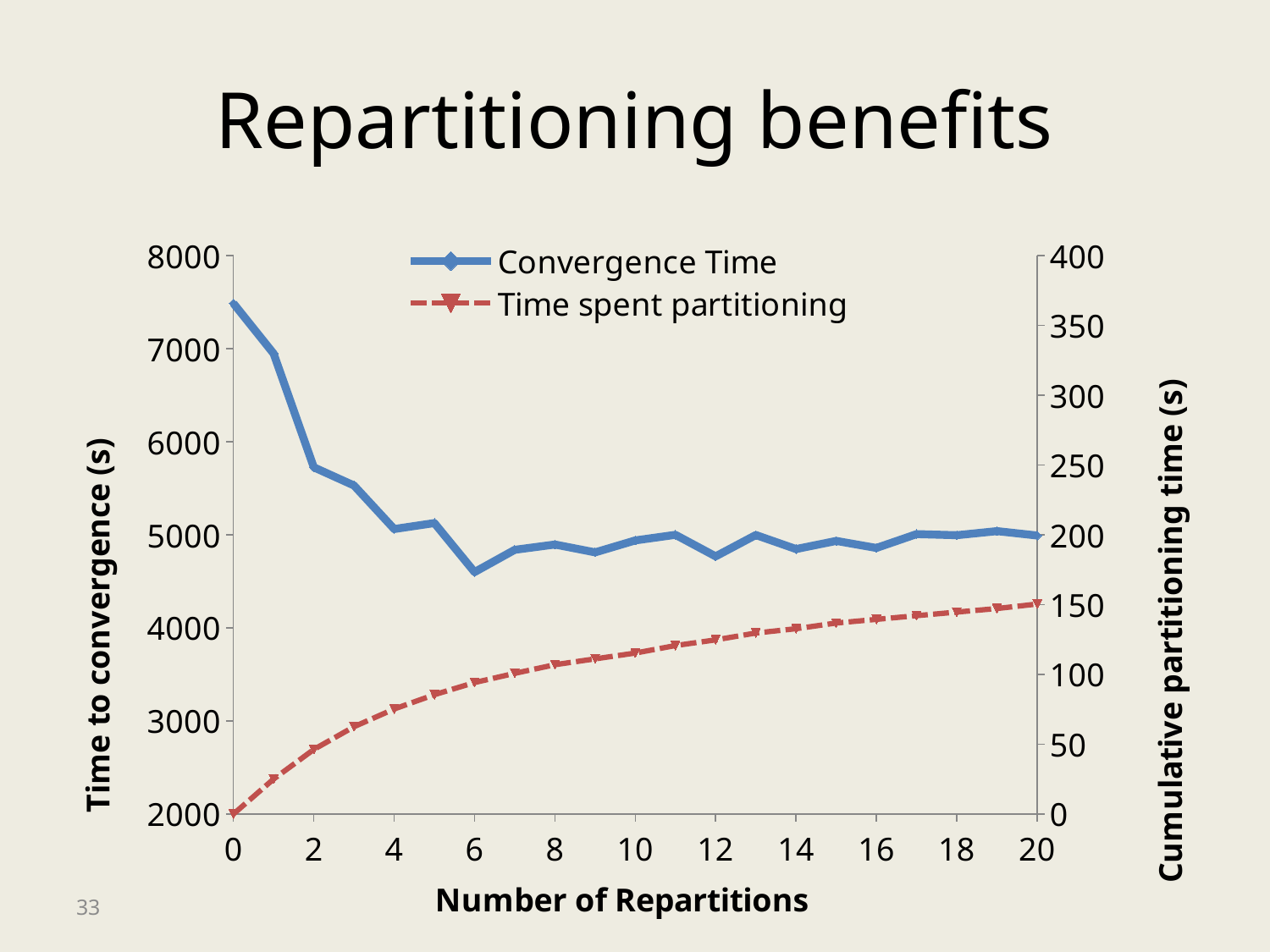
What kind of chart is shown on the slide? line chart What is the value of Time spent partitioning at 0 repartitions? 0 Is the Convergence Time at 6 repartitions greater or less than 5000? less Does the Time spent partitioning series rise or fall as the number of repartitions increases? rise Is the Convergence Time at 0 repartitions greater or less than 7000? greater What is the label of the x axis? Number of Repartitions How many series does the legend list? 2 What is the title of the chart on the slide? Repartitioning benefits Is the Time spent partitioning at 10 repartitions greater or less than 150? less Does the Convergence Time series rise or fall as the number of repartitions increases from 0 to 6? fall